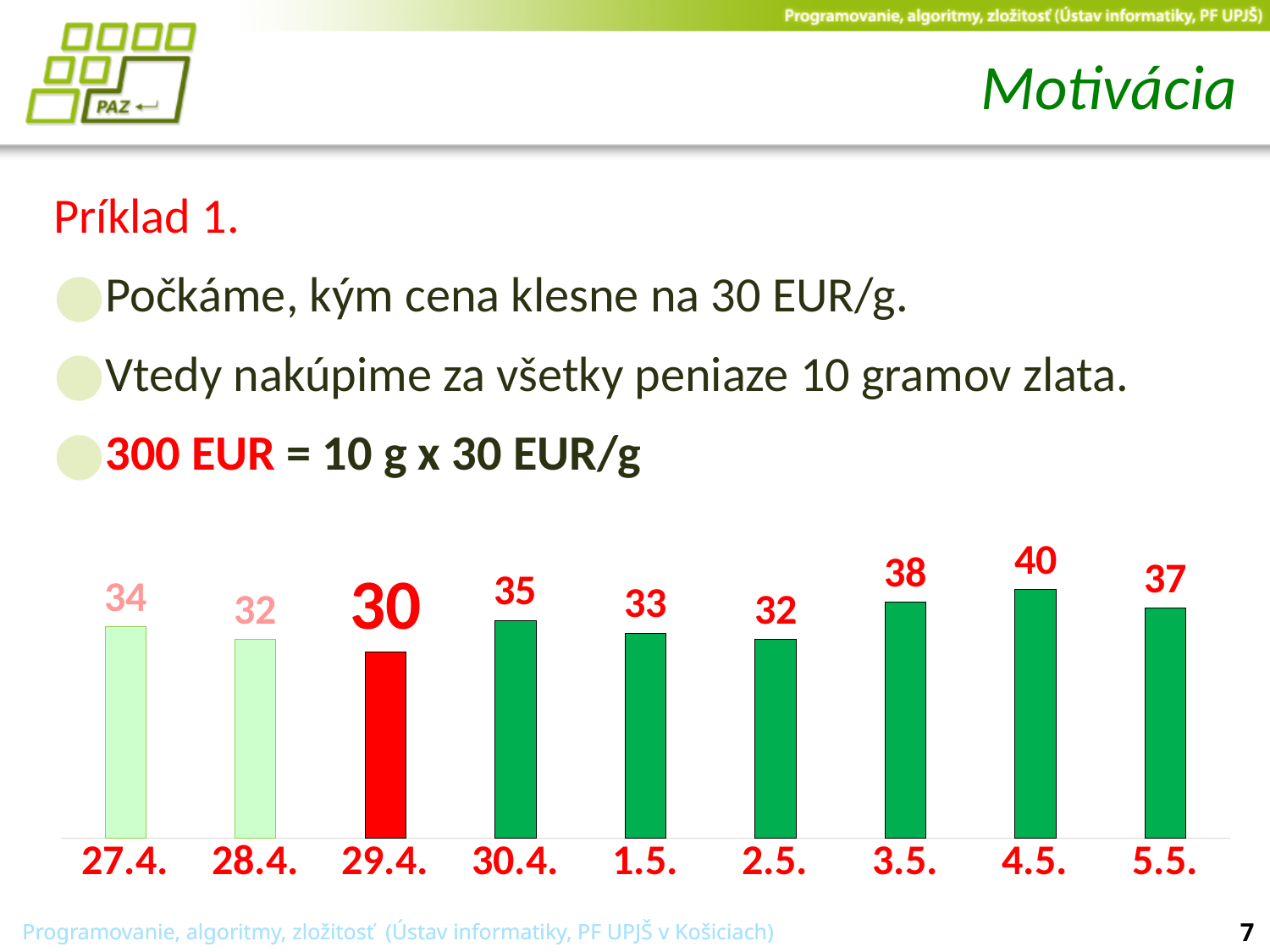
Which date has the highest value? 4.5. What is the difference between the values for 4.5. and 29.4.? 10 Which is larger, the value for 28.4. or the value for 5.5.? 5.5. What is the value shown for 3.5.? 38 What is the value shown for 29.4.? 30 What kind of chart is this? bar chart Which bar is coloured red? 29.4. What is the value shown for 27.4.? 34 Do the values rise or fall from 29.4. to 30.4.? rise Which date has the lowest value? 29.4. What is the difference between the values for 30.4. and 1.5.? 2 How many dates are shown on the x axis? 9